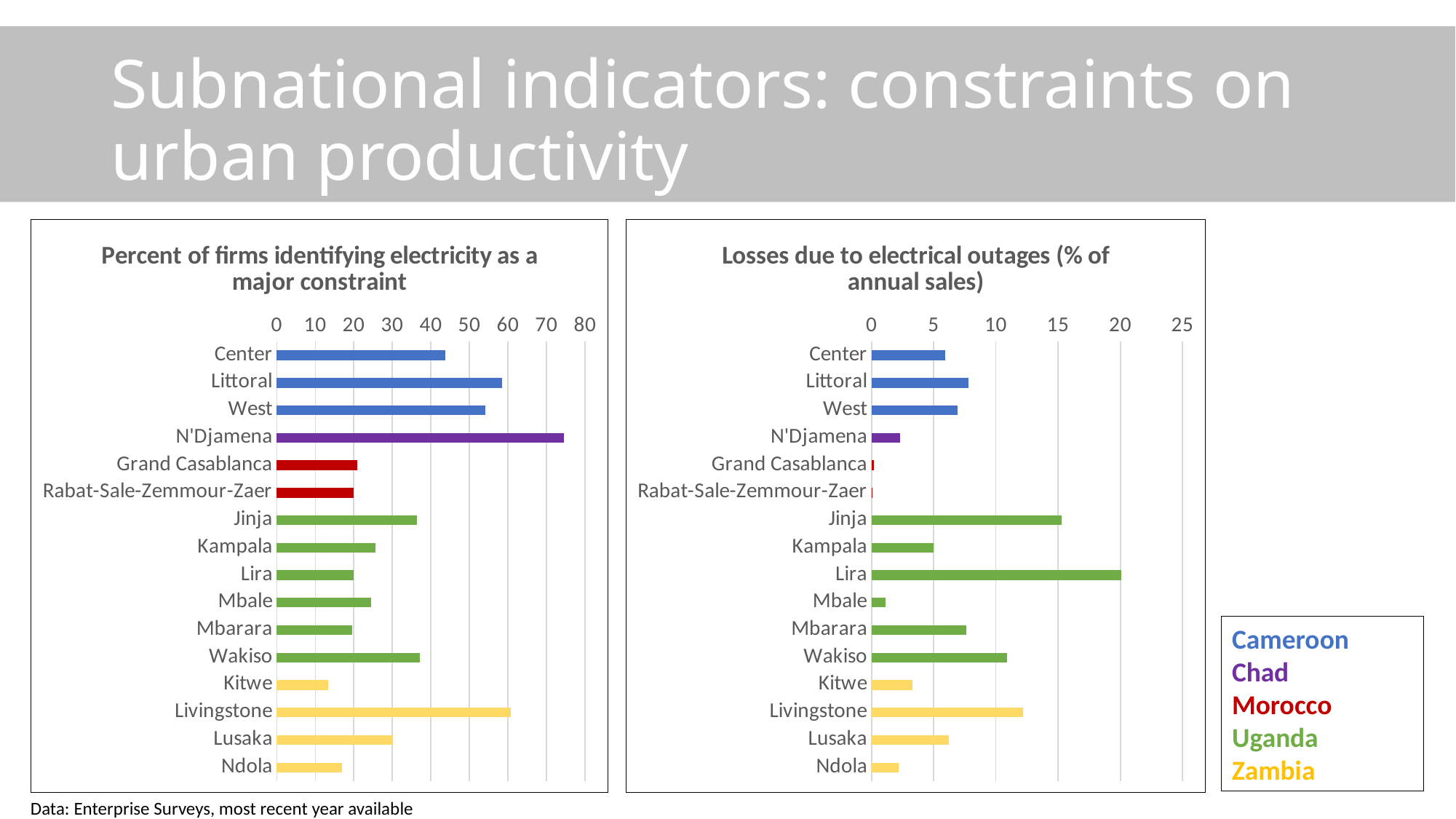
In the 'Percent of firms identifying electricity as a major constraint' chart, is the value for N'Djamena greater or less than 70? greater In the 'Losses due to electrical outages (% of annual sales)' chart, which region has the highest value? Lira In the 'Percent of firms identifying electricity as a major constraint' chart, which region has the highest value? N'Djamena In the 'Percent of firms identifying electricity as a major constraint' chart, is the value for Kitwe greater or less than 20? less How many countries does the colour legend on the right of the slide list? 5 In the 'Losses due to electrical outages (% of annual sales)' chart, which is larger, Mbarara or Kampala? Mbarara How many regions are plotted in the 'Losses due to electrical outages (% of annual sales)' chart? 16 In the 'Losses due to electrical outages (% of annual sales)' chart, is the value for Jinja greater or less than 10? greater What kind of chart is the 'Percent of firms identifying electricity as a major constraint' chart? bar chart In the 'Percent of firms identifying electricity as a major constraint' chart, which is larger, Jinja or Kampala? Jinja In the 'Percent of firms identifying electricity as a major constraint' chart, which region has the lowest value? Kitwe